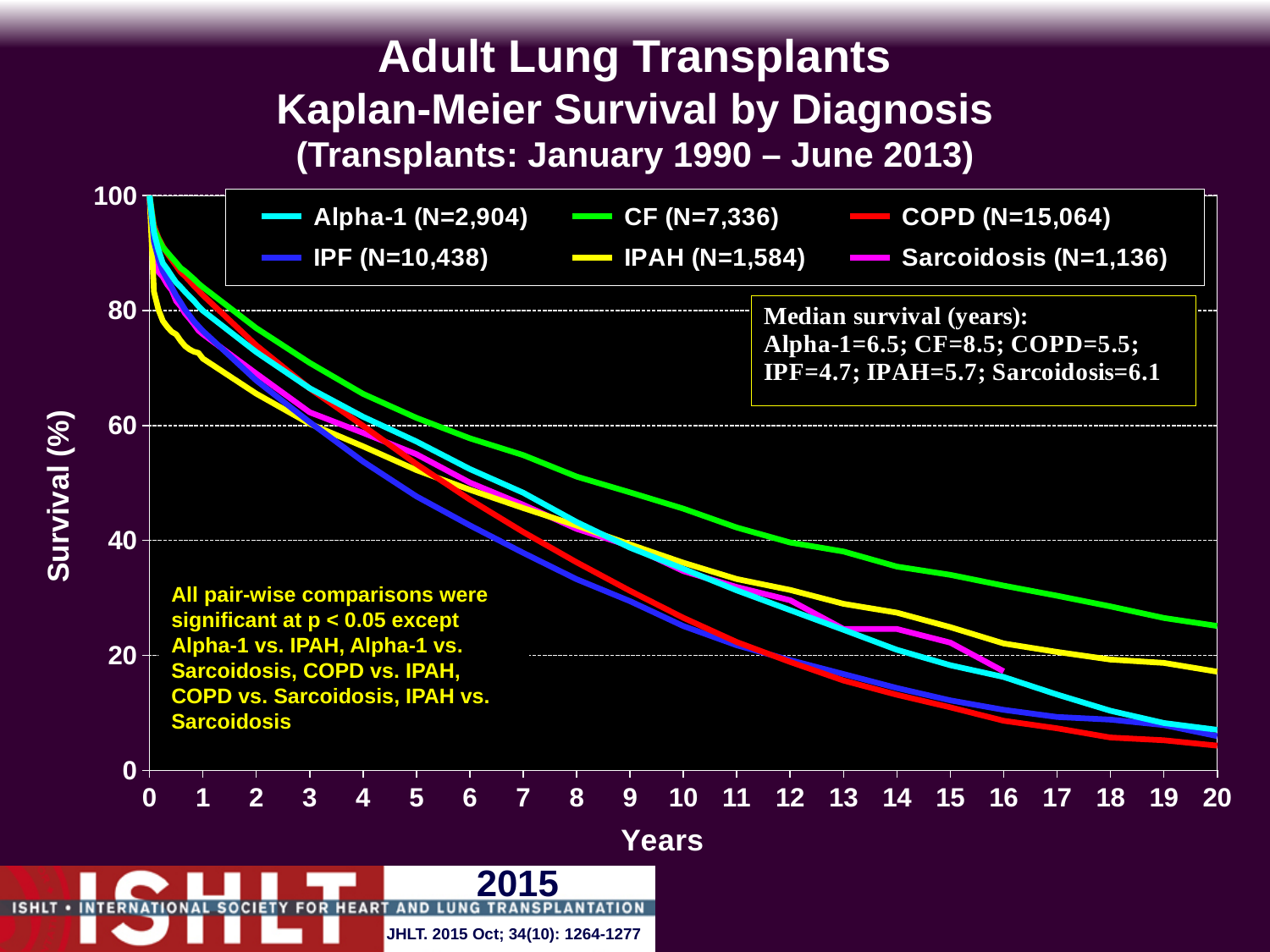
What is the median survival in years for CF? 8.5 What kind of chart is shown on the slide? Line chart Which diagnosis group has the highest median survival? CF What is the median survival in years for Sarcoidosis? 6.1 Which diagnosis group has the lowest median survival? IPF How many diagnosis groups does the legend list? 6 How many transplants (N) are in the COPD group according to the legend? 15,064 Which has a higher median survival, Alpha-1 or COPD? Alpha-1 Is the survival for COPD at 20 years greater or less than 20? less What is the median survival in years for IPF? 4.7 What is the difference in median survival (years) between CF and IPF? 3.8 Is the survival for CF at 10 years greater or less than 40? greater